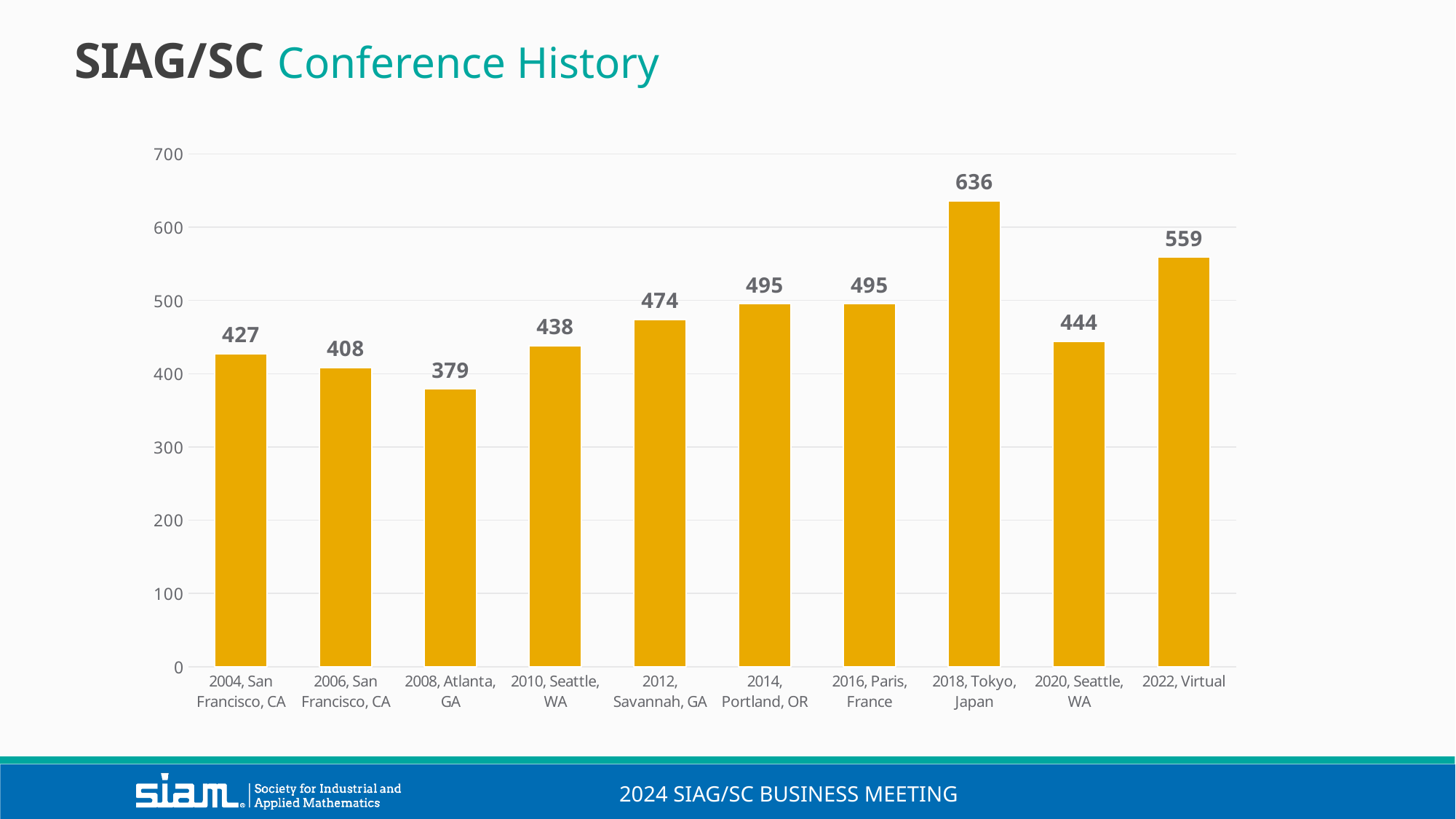
What kind of chart is shown on the slide? Bar chart Which category has the highest value? 2018, Tokyo, Japan What is the difference between the values for 2018, Tokyo, Japan and 2022, Virtual? 77 Which category has the lowest value? 2008, Atlanta, GA What is the value for 2022, Virtual? 559 Is the value for 2010, Seattle, WA greater or less than 400? greater What is the value for 2018, Tokyo, Japan? 636 What is the value for 2008, Atlanta, GA? 379 How many categories are shown on the x axis? 10 Which is larger, the value for 2012, Savannah, GA or the value for 2020, Seattle, WA? 2012, Savannah, GA What is the difference between the values for 2004, San Francisco, CA and 2006, San Francisco, CA? 19 What is the title of the slide? SIAG/SC Conference History